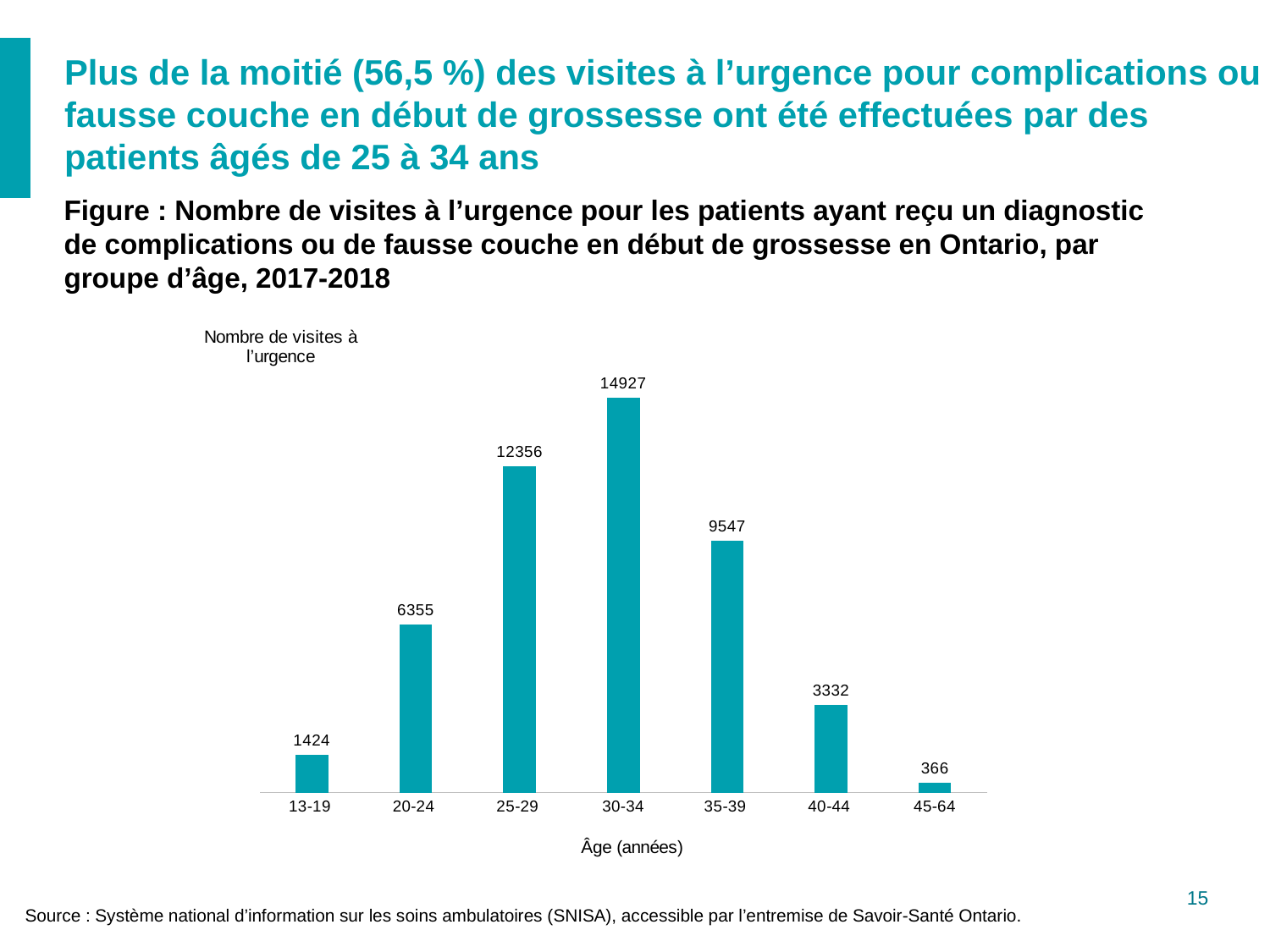
What is the number of emergency department visits for the 45-64 age group? 366 Which age group has more emergency department visits, 20-24 or 35-39? 35-39 How many age groups are shown on the chart? 7 Which age group has the lowest number of emergency department visits? 45-64 What is the difference in emergency department visits between the 30-34 and 25-29 age groups? 2571 What type of chart is shown on the slide? Bar chart What is the difference in emergency department visits between the 35-39 and 40-44 age groups? 6215 What is the number of emergency department visits for the 30-34 age group? 14927 What is the number of emergency department visits for the 20-24 age group? 6355 What is the label of the x axis of the chart? Âge (années) Do the values rise or fall from the 30-34 age group to the 45-64 age group? Fall Which age group has the highest number of emergency department visits? 30-34